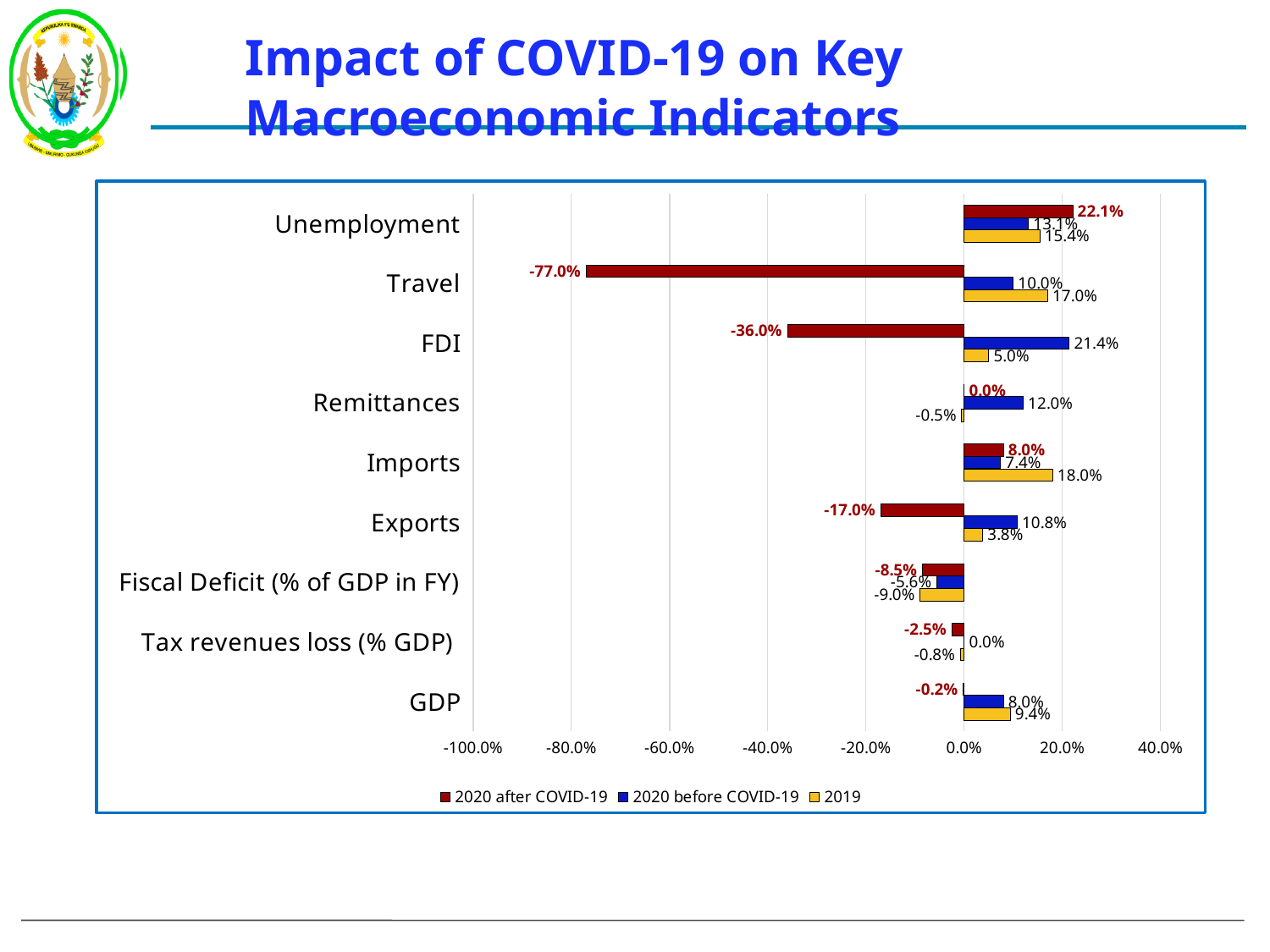
What is the 2020 before COVID-19 value for FDI? 21.4% Which category has the highest 2020 before COVID-19 value? FDI Which is larger for GDP: the 2020 before COVID-19 value or the 2019 value? 2019 What is the difference between the 2019 value and the 2020 after COVID-19 value for Exports? 20.8 percentage points How many series does the legend list? 3 What is the 2020 after COVID-19 value for Unemployment? 22.1% Which category has the lowest 2020 after COVID-19 value? Travel How many categories are shown on the chart? 9 What is the 2019 value for Imports? 18.0% What kind of chart is shown on the slide? Bar chart Which series is shown in dark red? 2020 after COVID-19 What is the 2020 after COVID-19 value for Travel? -77.0%